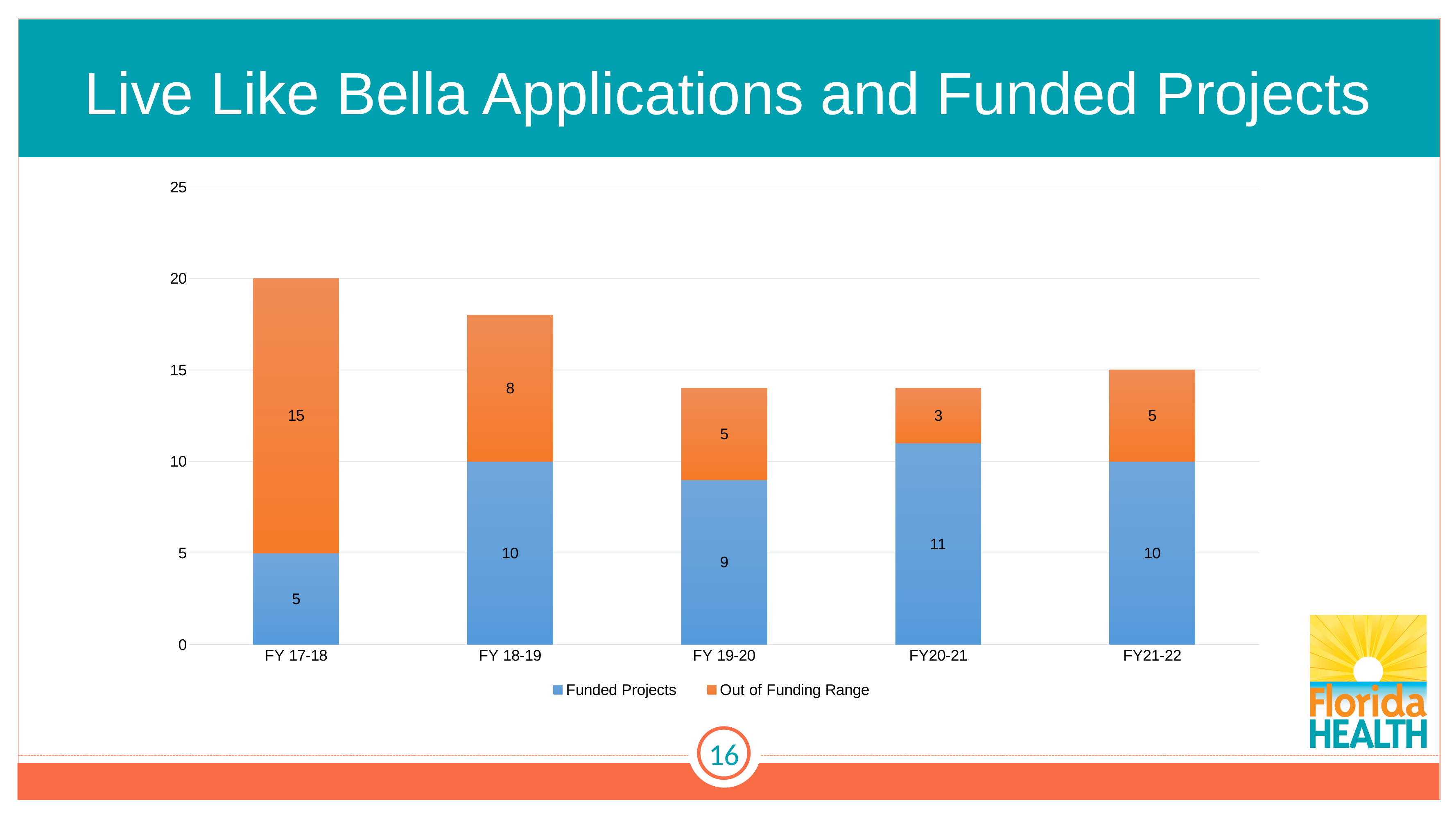
Which is larger: Funded Projects in FY 19-20 or Funded Projects in FY21-22? FY21-22 What is the value for Out of Funding Range in FY 18-19? 8 How many series does the legend list? 2 What kind of chart is shown on the slide? Stacked bar chart Which fiscal year has the highest Out of Funding Range value? FY 17-18 What is the value for Funded Projects in FY 17-18? 5 What is the total of the stacked bar for FY21-22? 15 How many fiscal years are shown on the x axis? 5 What is the difference between Out of Funding Range in FY 17-18 and FY 18-19? 7 What is the total of the stacked bar for FY 17-18? 20 Which fiscal year has the lowest Funded Projects value? FY 17-18 What is the value for Funded Projects in FY20-21? 11